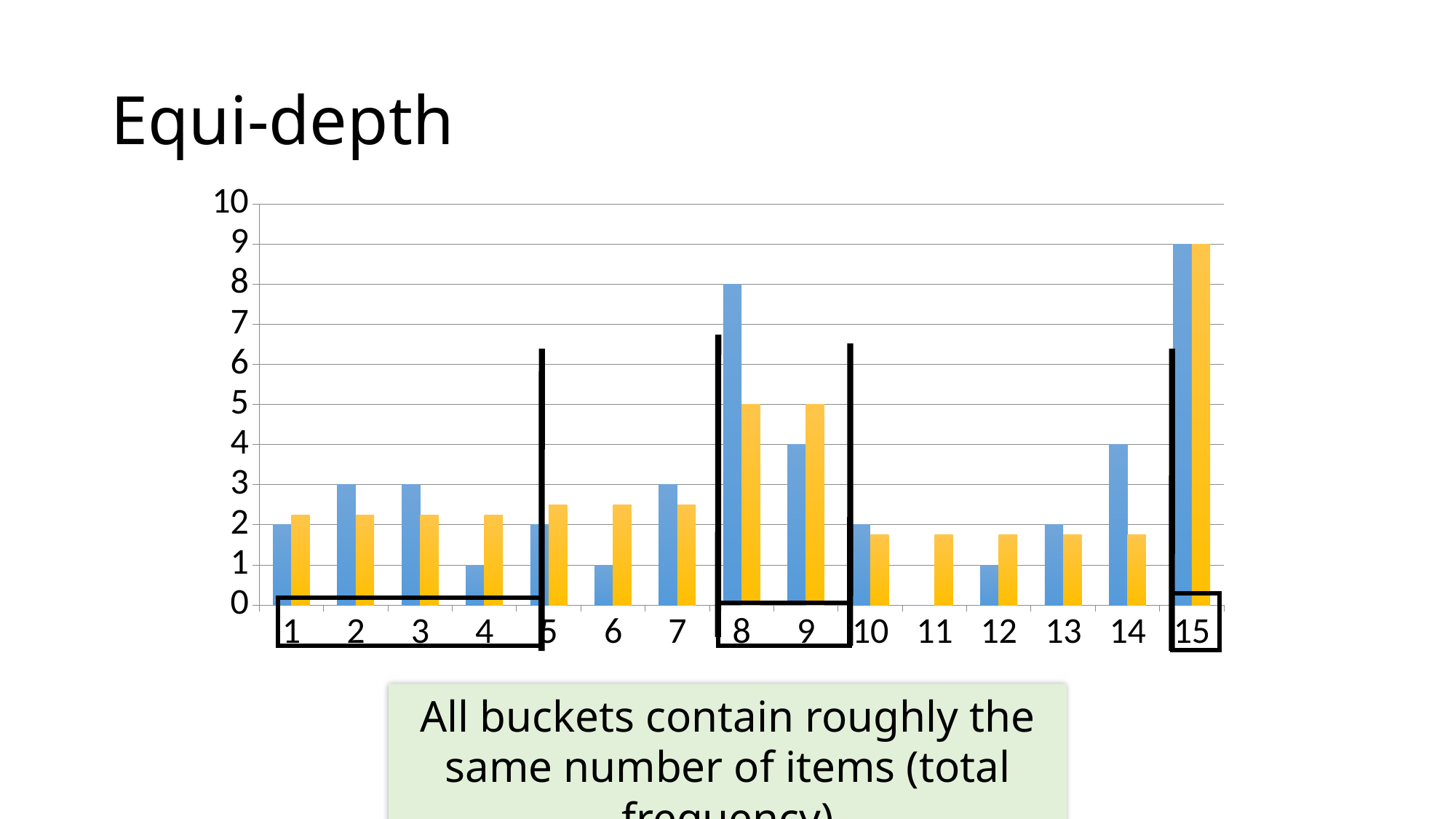
What is the value of the blue bar for category 15? 9 What kind of chart is shown on the slide? bar chart How many categories are shown along the x axis? 15 Which is larger, the blue bar for category 8 or the blue bar for category 9? category 8 Which category has the highest blue bar? 15 Is the value of the orange bar for category 9 greater or less than 4? greater What is the value of the orange bar for category 8? 5 What is the difference between the blue bar for category 15 and the blue bar for category 8? 1 What is the value of the blue bar for category 14? 4 What is the title of the slide containing the chart? Equi-depth What is the value of the blue bar for category 8? 8 How many buckets are outlined with black boxes on the chart? 3